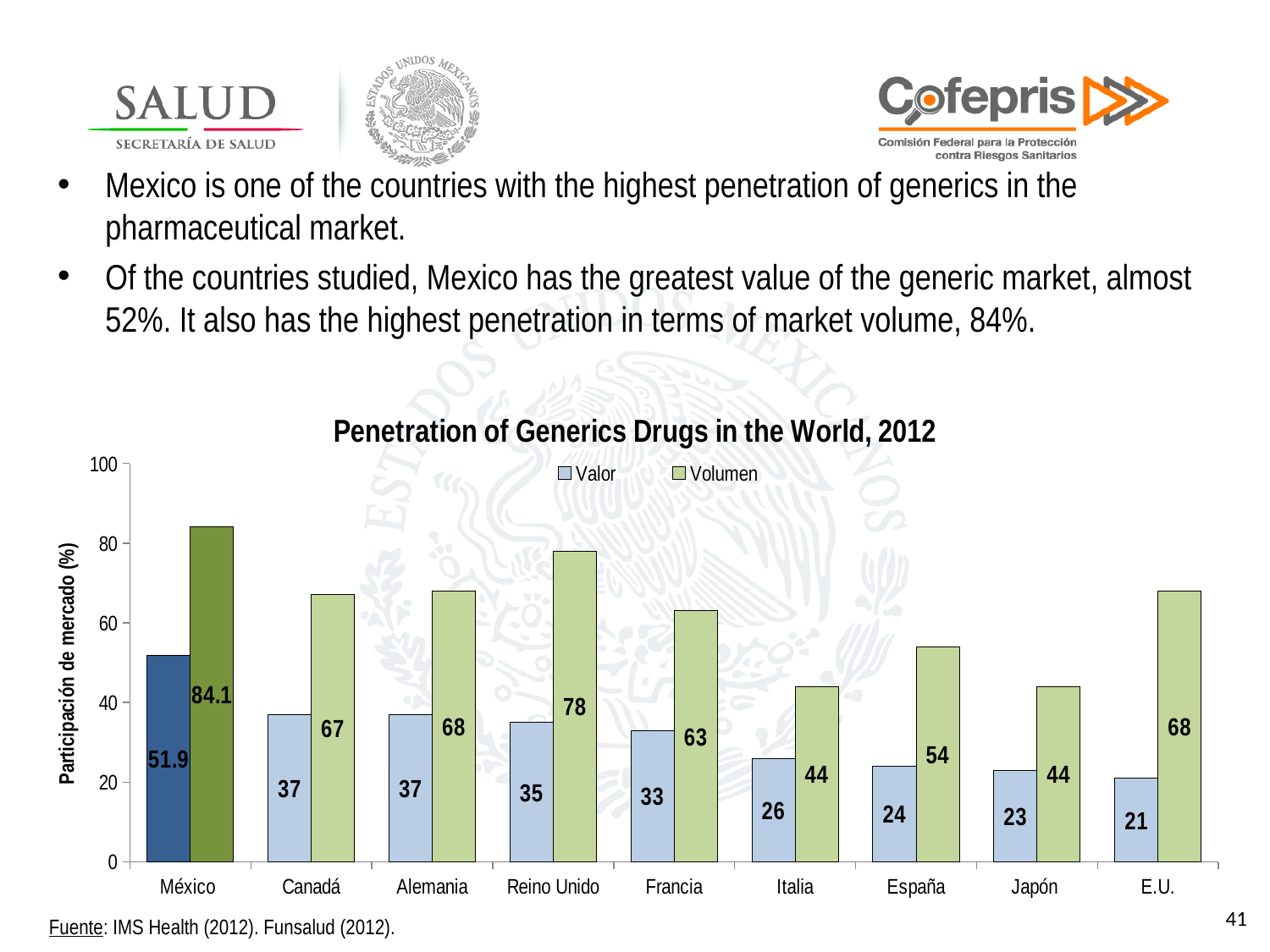
What is the Volumen value for Reino Unido? 78 What kind of chart is shown on the slide? bar chart Which is larger, the Volumen value for Francia or the Volumen value for Canadá? Canadá Which country has the highest Volumen value? México What is the Valor value for México? 51.9 What is the difference between the Volumen and Valor values for España? 30 How many series does the legend list? 2 What is the Valor value for E.U.? 21 Is the Volumen value for Italia greater or less than 40? greater Which country has the lowest Valor value? E.U. How many countries are shown on the x axis? 9 What is the title of the chart? Penetration of Generics Drugs in the World, 2012